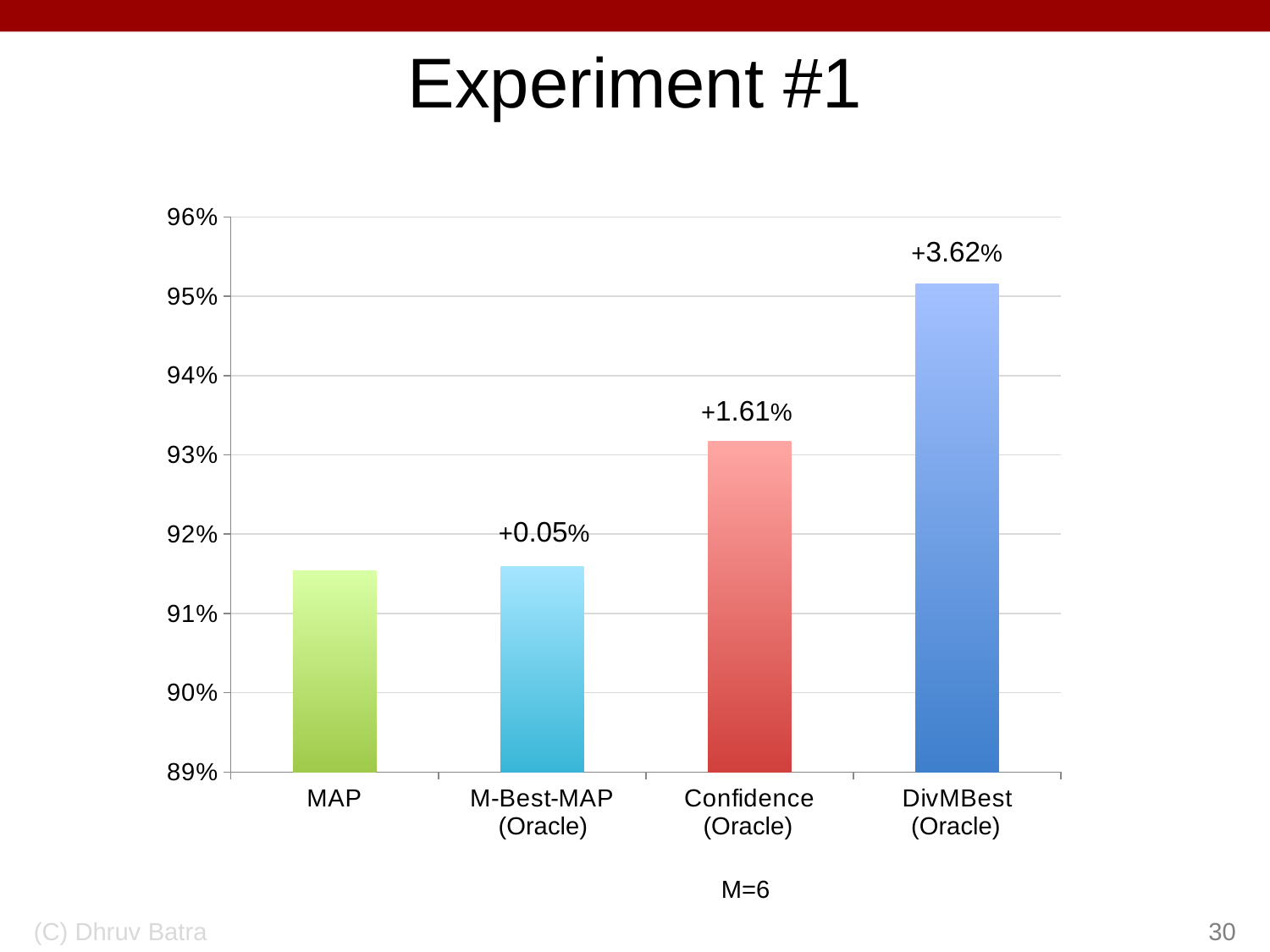
Which category has the highest bar? DivMBest (Oracle) What improvement is printed above the Confidence (Oracle) bar? +1.61% Is the value for Confidence (Oracle) greater or less than 94%? less What improvement is printed above the M-Best-MAP (Oracle) bar? +0.05% What kind of chart is shown on the slide? bar chart Which is larger, the value for Confidence (Oracle) or the value for DivMBest (Oracle)? DivMBest (Oracle) What improvement is printed above the DivMBest (Oracle) bar? +3.62% Do the bar values rise or fall from left to right along the x axis? rise What setting is noted below the x axis of the chart? M=6 How many categories are plotted on the chart? 4 Is the value for DivMBest (Oracle) greater or less than 94%? greater Is the value for MAP greater or less than 91%? greater